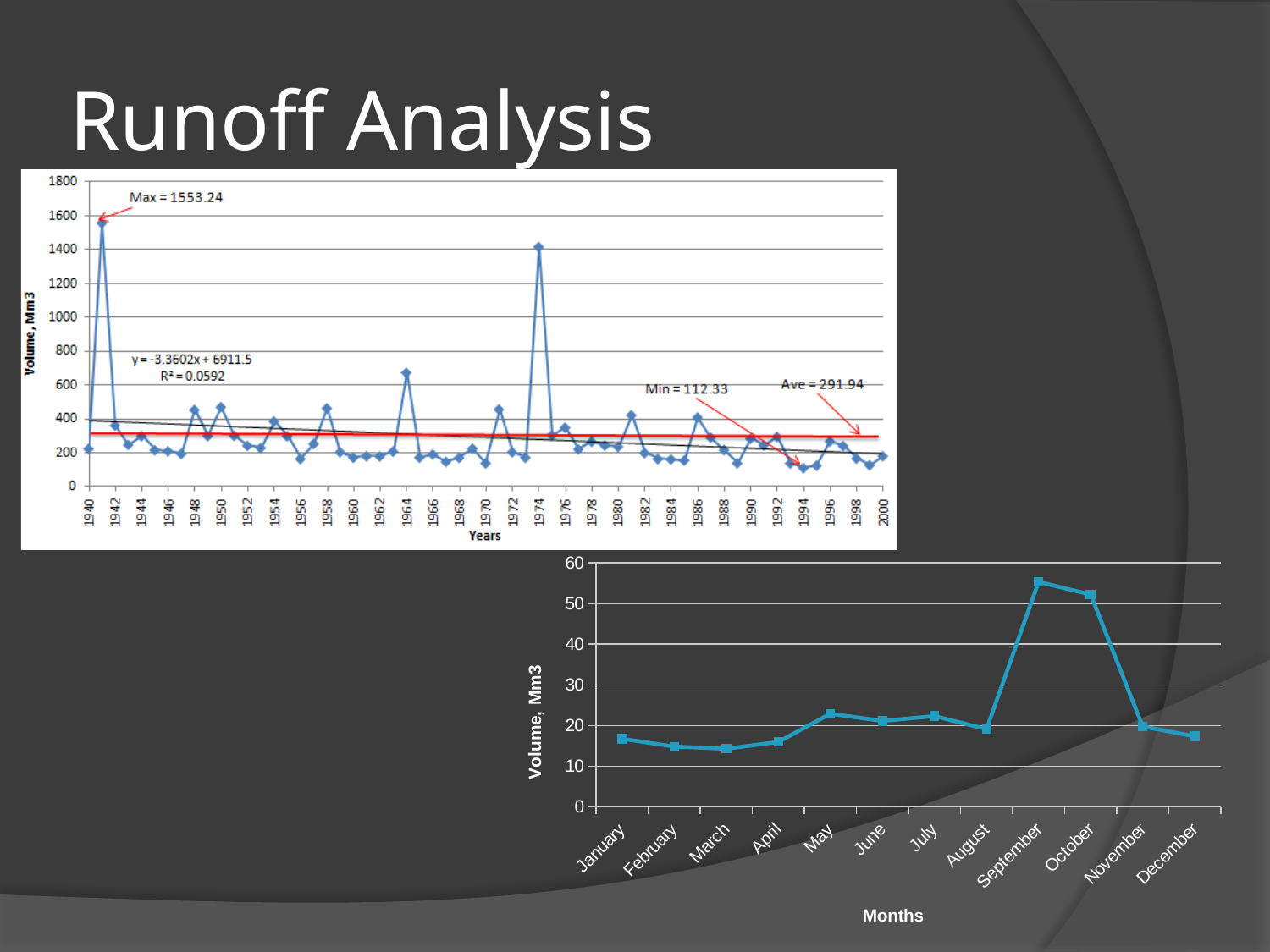
In the top chart, what is the minimum value annotated on the chart? 112.33 What kind of chart is the top chart on the slide? line chart In the top chart, what is the label of the x axis? Years In the bottom chart, how many months are plotted along the x axis? 12 In the top chart, what is the maximum value annotated on the chart? 1553.24 In the top chart, what is the average value annotated on the chart? 291.94 In the bottom chart, is the value for September greater or less than 50? greater In the bottom chart, which month has the highest volume? September In the bottom chart, is the value for January greater or less than 20? less What kind of chart is the bottom chart on the slide? line chart In the bottom chart, do the values rise or fall from September to December? fall In the top chart, which year has the highest runoff volume? 1941